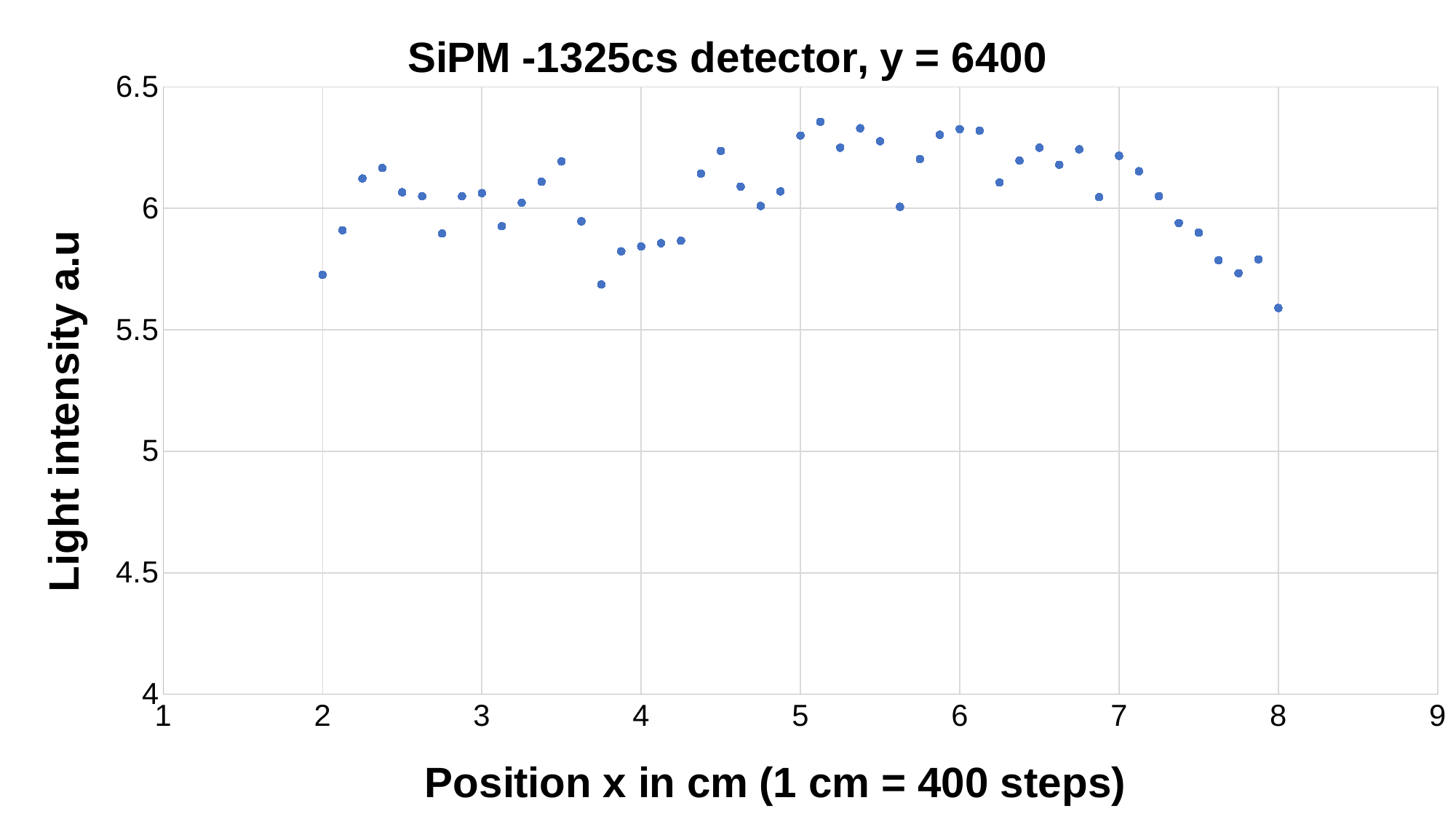
Is the light intensity at position x = 8 cm greater or less than 6? less Is the light intensity at position x = 2 cm greater or less than 6? less Is the light intensity at position x = 6 cm greater or less than 6? greater What kind of chart is shown on the slide? scatter chart Between position x = 7 cm and x = 8 cm, do the light intensity values rise or fall? fall What is the label of the x axis? Position x in cm (1 cm = 400 steps) What is the title of the chart? SiPM -1325cs detector, y = 6400 Which has the higher light intensity, position x = 2 cm or position x = 5 cm? x = 5 cm At which position x is the light intensity lowest? 8 cm